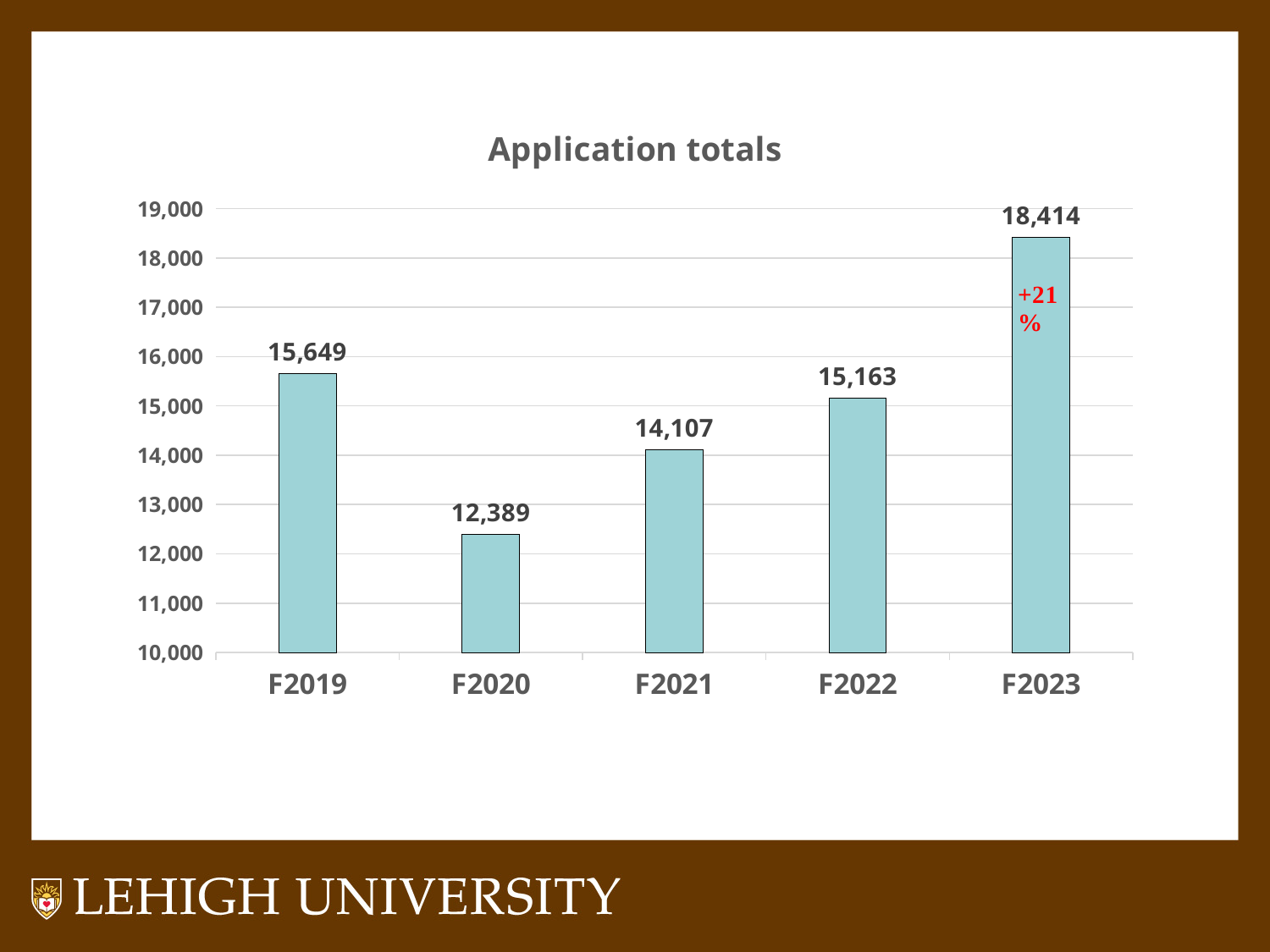
What is the application total for F2023? 18,414 What is the application total for F2021? 14,107 What is the application total for F2020? 12,389 What is the application total for F2019? 15,649 Is the value for F2021 greater or less than 15,000? less What kind of chart is shown on the slide? bar chart How many years are shown on the x axis? 5 What percentage change is annotated on the F2023 bar? +21% What is the difference between the application totals for F2023 and F2022? 3,251 Which year has the lowest application total? F2020 Which year has the highest application total? F2023 Which is larger, the application total for F2019 or for F2022? F2019